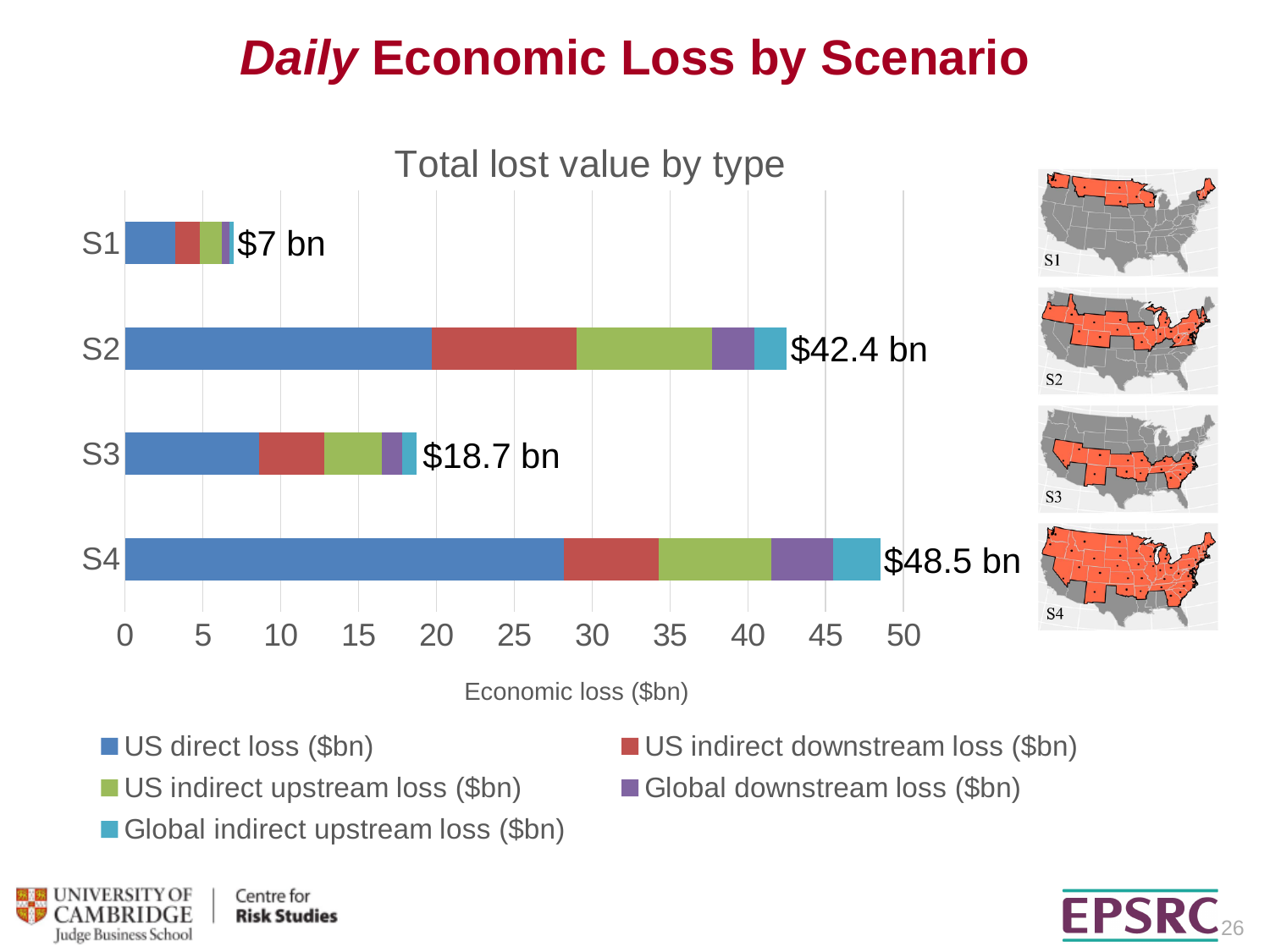
How many scenarios are plotted in the chart? 4 How many series does the legend list? 5 Which scenario has the highest total economic loss? S4 What is the total daily economic loss shown for scenario S3? $18.7 bn What type of chart is shown on the slide? Stacked bar chart What is the difference between the total losses for S3 and S1? $11.7 bn Is the US direct loss for S4 greater or less than 25? greater What is the total daily economic loss shown for scenario S4? $48.5 bn What is the difference between the total losses for S4 and S2? $6.1 bn Which scenario has the lowest total economic loss? S1 Which scenario has a larger total loss, S2 or S3? S2 What is the total daily economic loss shown for scenario S2? $42.4 bn